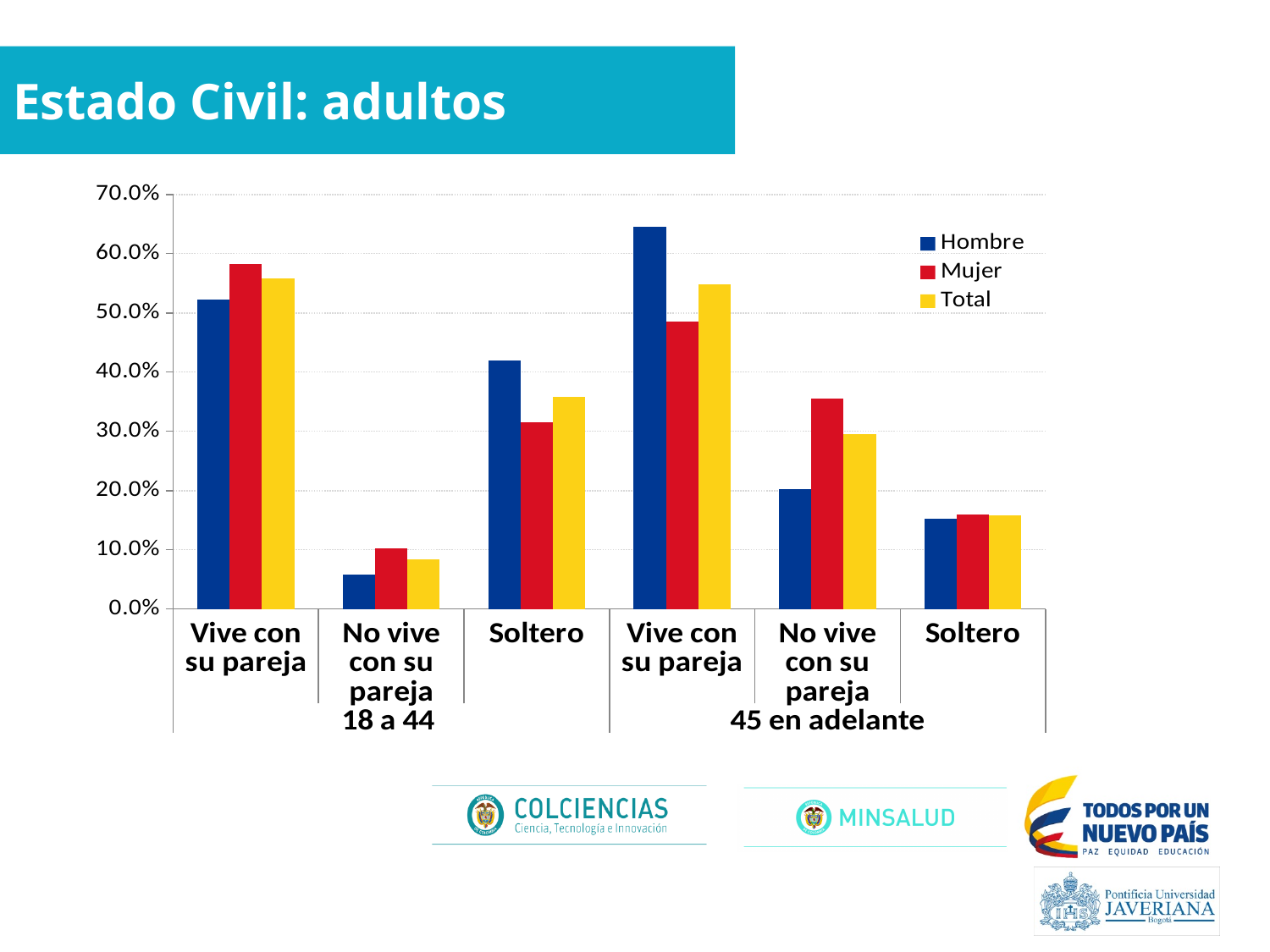
What is the title of the slide? Estado Civil: adultos For 'Soltero' in the 18 a 44 group, which is larger, Hombre or Mujer? Hombre What kind of chart is shown on the slide? bar chart What colour represents the Total series in the legend? yellow Which category has the highest Hombre value? Vive con su pareja (45 en adelante) Is the Total value for 'Soltero' in the 18 a 44 group greater or less than 30.0%? greater Is the Mujer value for 'No vive con su pareja' in the 18 a 44 group greater or less than 20.0%? less For 'No vive con su pareja' in the 45 en adelante group, which is larger, Hombre or Mujer? Mujer Is the Hombre value for 'Vive con su pareja' in the 45 en adelante group greater or less than 60.0%? greater How many series does the legend list? 3 Which category has the lowest Hombre value? No vive con su pareja (18 a 44) How many categories are shown along the x axis? 6